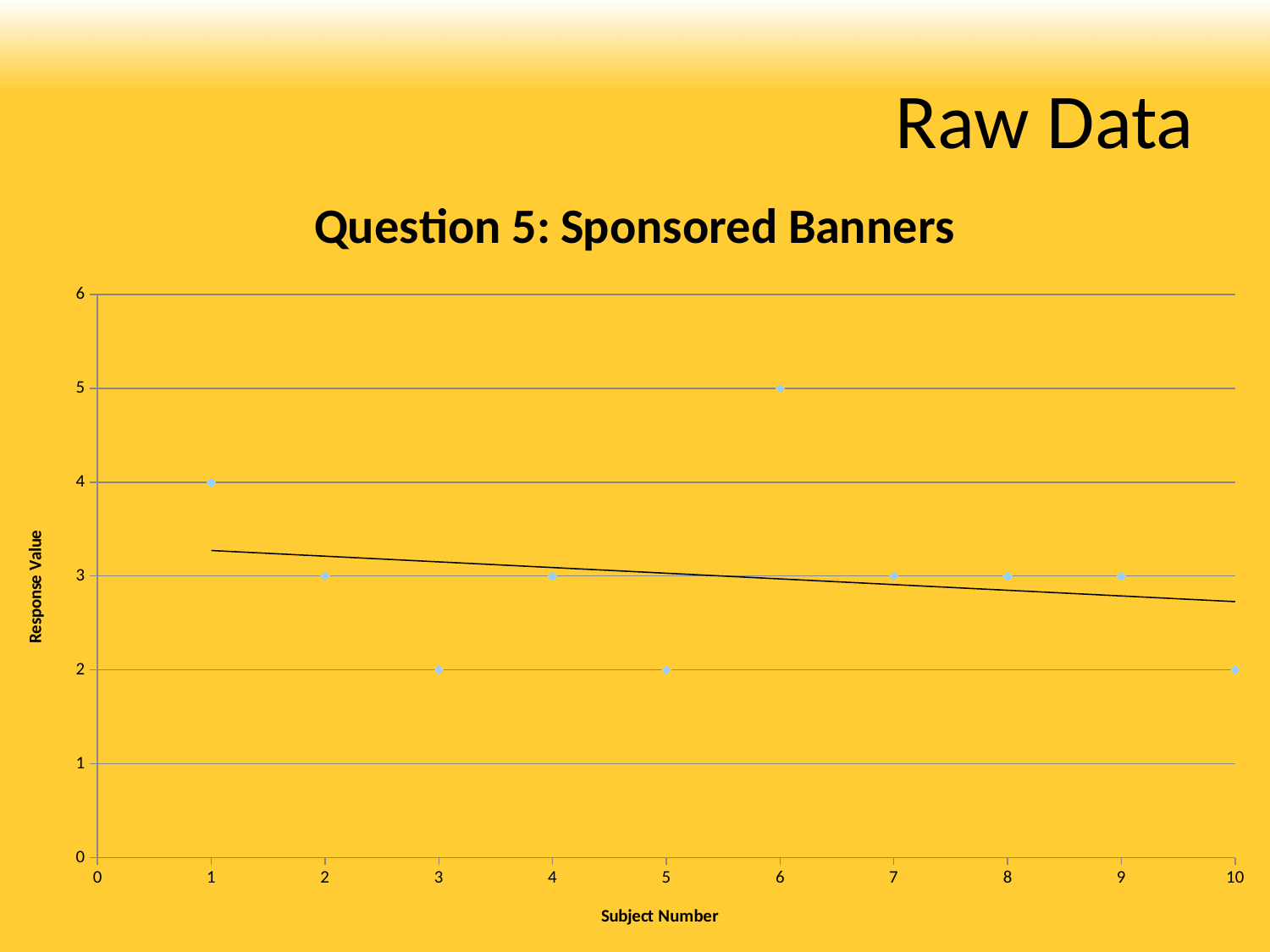
What is the response value for subject number 3? 2 What is the title of the chart? Question 5: Sponsored Banners What is the response value for subject number 6? 5 What is the response value for subject number 1? 4 What is the difference between the response values for subject 6 and subject 10? 3 Which subject number has the highest response value? 6 What is the response value for subject number 8? 3 Which has a larger response value, subject 1 or subject 5? Subject 1 What is the label of the vertical axis? Response Value How many subjects have a response value of 3? 5 How many data points are plotted on the chart? 10 Does the trend line rise or fall as the subject number increases? Falls